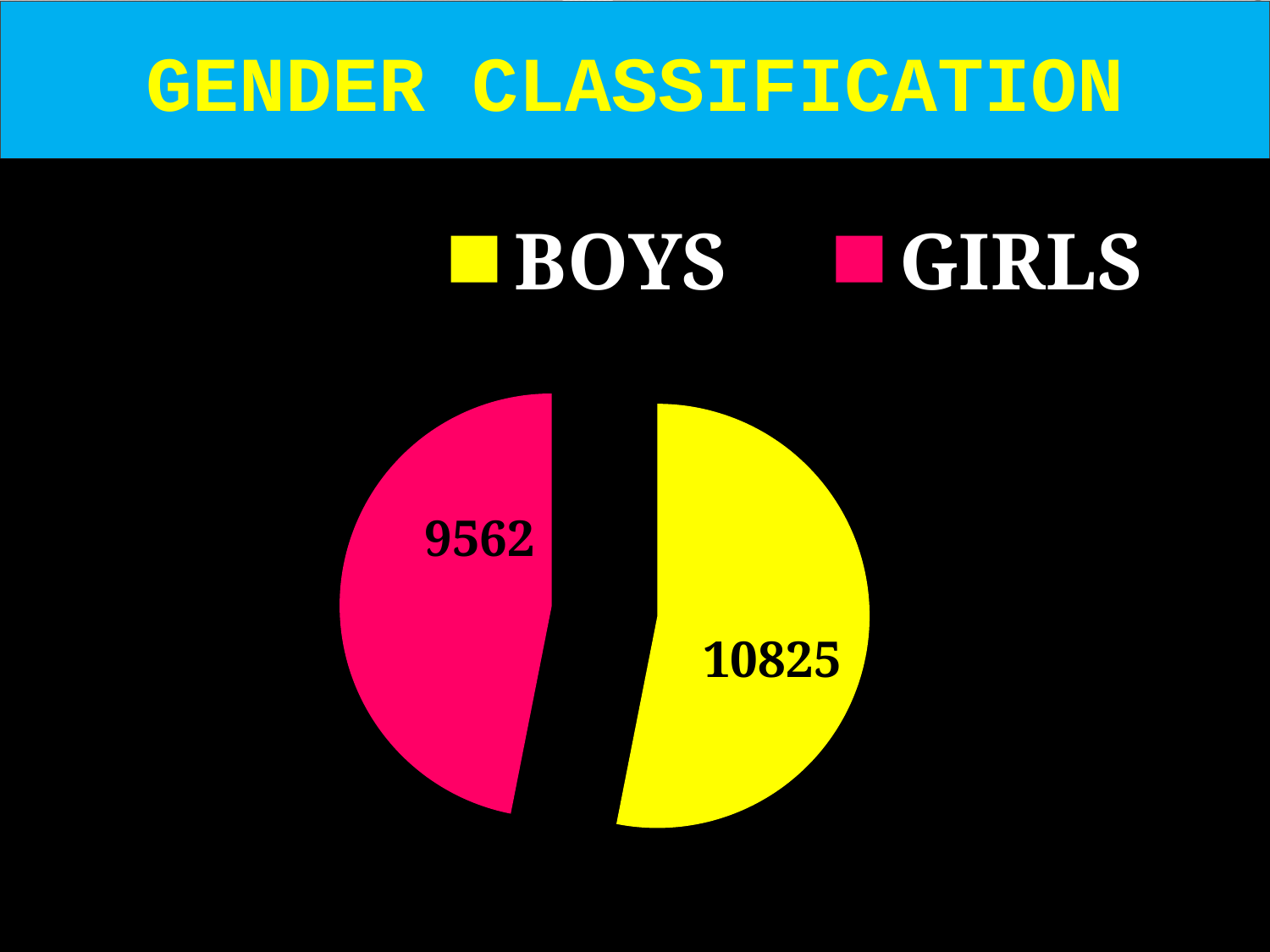
What is the value for BOYS in the pie chart? 10825 What is the title of the chart on the slide? GENDER CLASSIFICATION Which category has the smallest slice in the pie chart? GIRLS What is the difference between the BOYS value and the GIRLS value? 1263 What colour represents GIRLS in the pie chart? Pink How many entries does the legend list? 2 Which is larger, the value for BOYS or the value for GIRLS? BOYS What kind of chart is shown on the slide? Pie chart What is the total of the two values shown in the pie chart? 20387 Which category has the largest slice in the pie chart? BOYS How many slices does the pie chart have? 2 What is the value for GIRLS in the pie chart? 9562